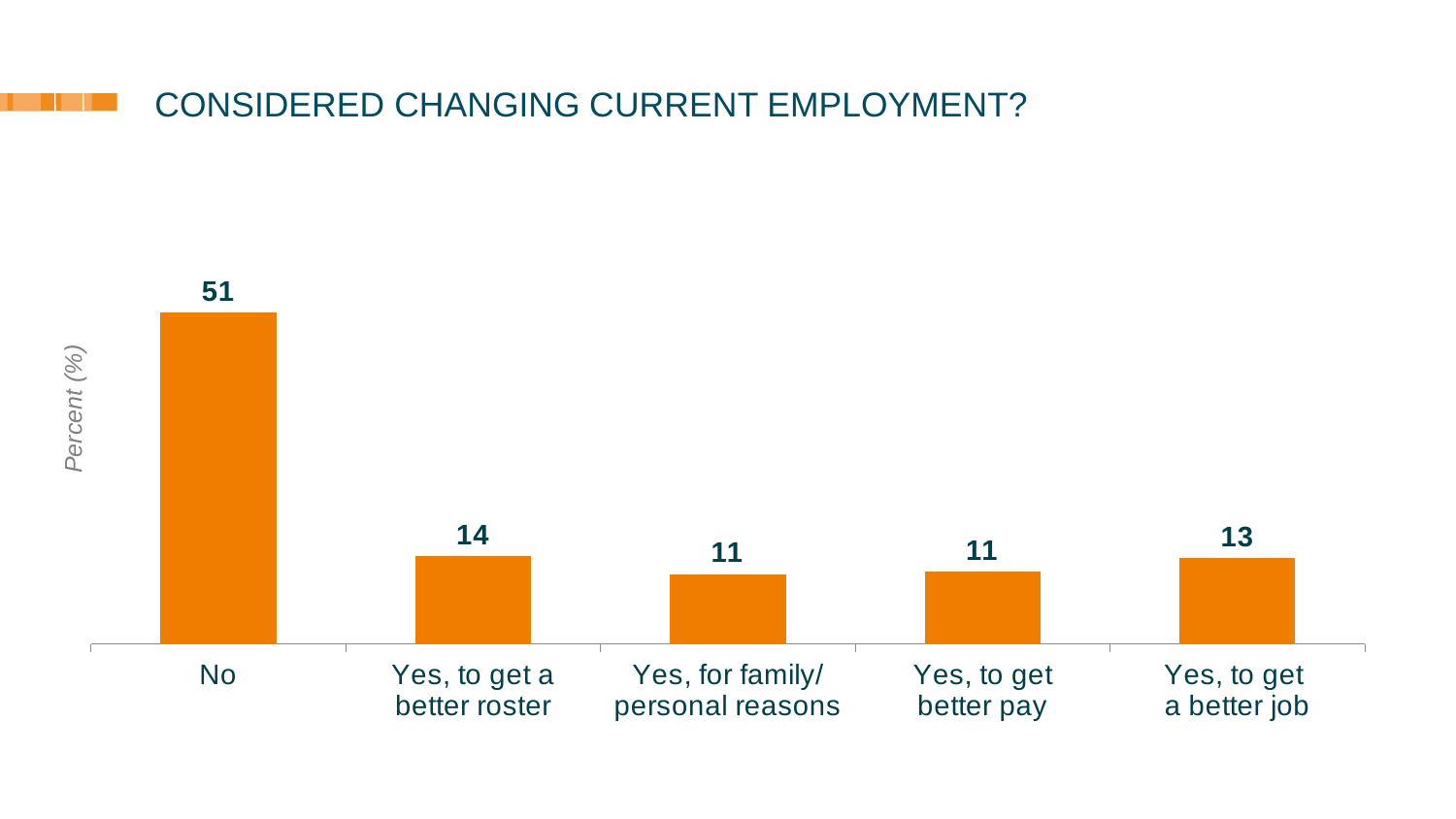
How many categories are shown on the chart? 5 What is the label on the vertical axis? Percent (%) What is the value for "Yes, to get a better roster"? 14 What is the title of the chart? CONSIDERED CHANGING CURRENT EMPLOYMENT? What is the value for "No"? 51 Which is larger, the value for "Yes, to get a better roster" or the value for "Yes, for family/personal reasons"? Yes, to get a better roster What is the difference between the values for "Yes, to get a better roster" and "Yes, to get a better job"? 1 What is the value for "Yes, to get better pay"? 11 What is the value for "Yes, to get a better job"? 13 What kind of chart is shown on the slide? Bar chart Which category has the highest value? No What is the difference between the values for "No" and "Yes, to get a better roster"? 37